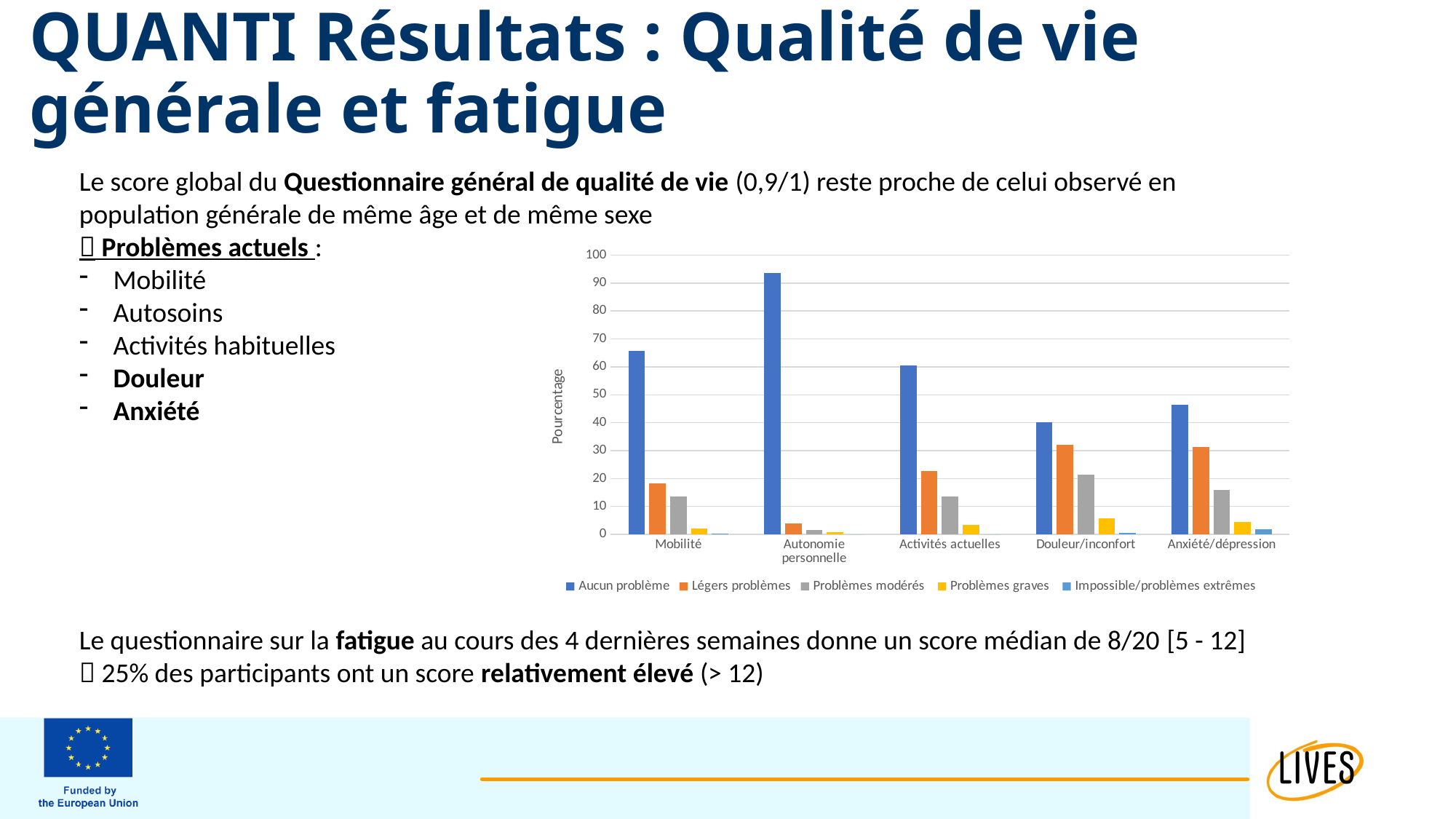
Is the 'Aucun problème' value for Autonomie personnelle greater or less than 90? greater Is the 'Aucun problème' value for Mobilité greater or less than 60? greater Which is larger: the 'Légers problèmes' value for Mobilité or for Activités actuelles? Activités actuelles How many series does the chart legend list? 5 What kind of chart is shown on the slide? bar chart Which category has the highest value for the 'Aucun problème' series? Autonomie personnelle Is the 'Légers problèmes' value for Douleur/inconfort greater or less than 30? greater Which category has the lowest value for the 'Aucun problème' series? Douleur/inconfort Which category has the highest value for the 'Légers problèmes' series? Douleur/inconfort How many categories are shown on the x axis of the chart? 5 What is the label of the vertical axis of the chart? Pourcentage